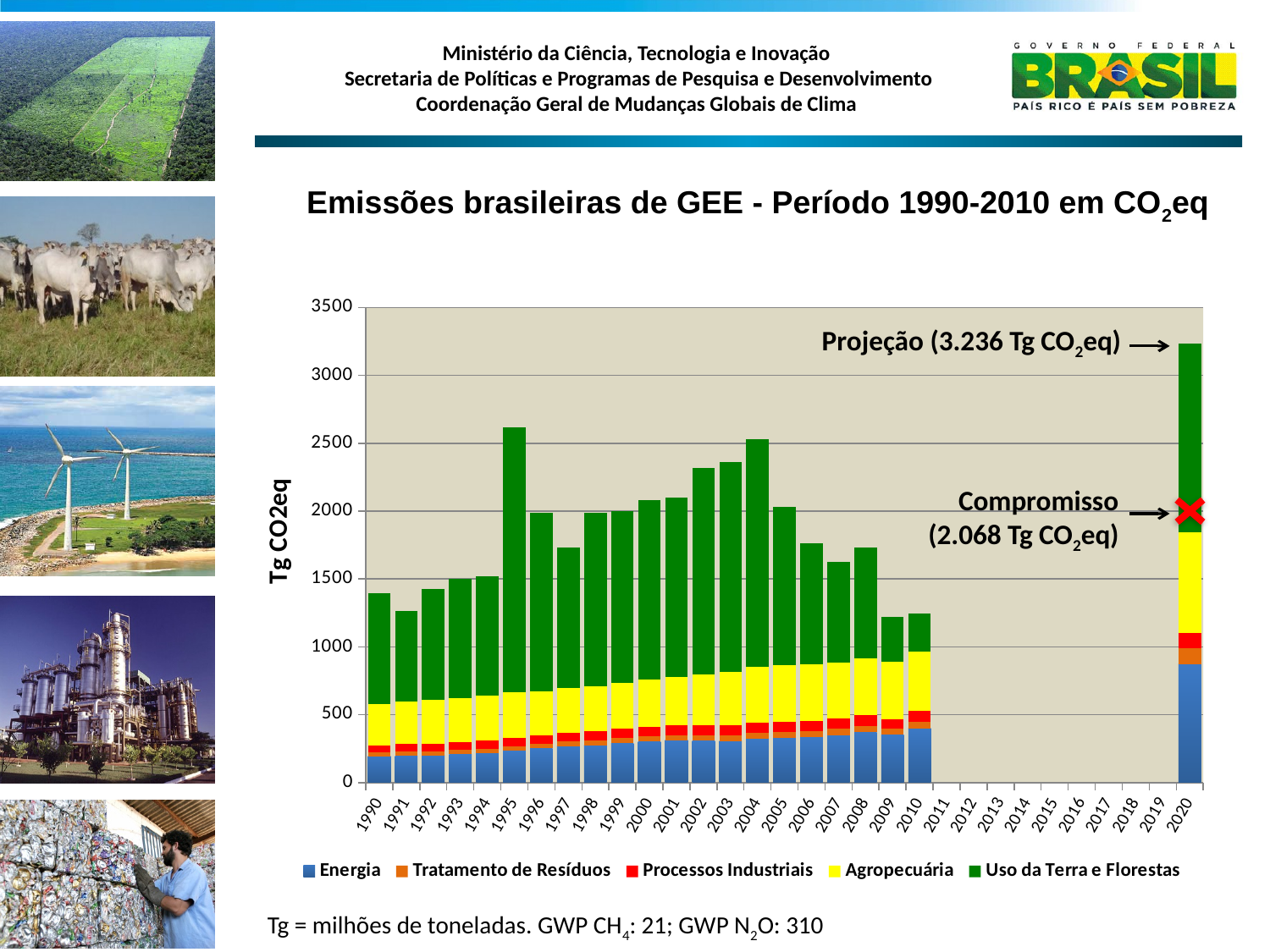
What kind of chart is shown on the slide? Stacked bar chart How many series does the legend list? 5 Is the total for 1995 greater or less than 2500? greater How many bars are plotted on the chart? 22 Which year has the larger total, 2008 or 2009? 2008 What is the value of the 'Compromisso' (commitment) marked on the chart? 2.068 Tg CO2eq What is the difference between the 2020 projection and the Compromisso value? 1.168 Tg CO2eq Which year between 1990 and 2010 has the highest total emissions? 1995 What is the projected total emission value shown for 2020? 3.236 Tg CO2eq Do total emissions rise or fall from 2004 to 2009? fall Which series is shown in green in the legend? Uso da Terra e Florestas Is the total for 2009 greater or less than 1500? less